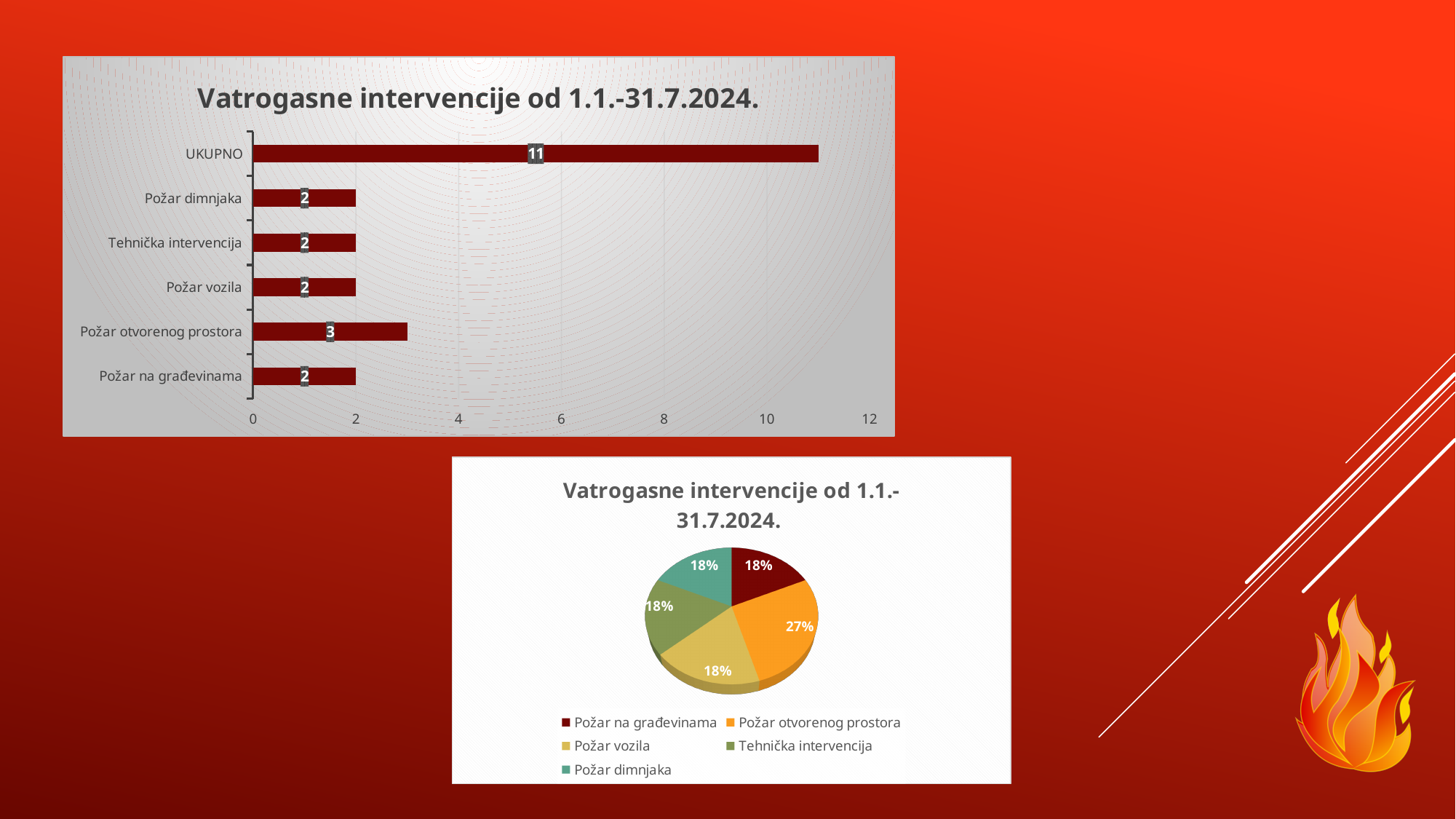
In the pie chart at the bottom of the slide, what share does Požar otvorenog prostora have? 27% In the bar chart at the top of the slide, what is the difference between UKUPNO and Požar otvorenog prostora? 8 In the bar chart at the top of the slide, what is the value for Požar dimnjaka? 2 In the bar chart at the top of the slide, what is the value for Požar otvorenog prostora? 3 How many categories are shown in the bar chart at the top of the slide? 6 What is the title of the bar chart at the top of the slide? Vatrogasne intervencije od 1.1.-31.7.2024. How many entries does the legend of the pie chart at the bottom of the slide list? 5 In the bar chart at the top of the slide, which category has the highest value? UKUPNO In the pie chart at the bottom of the slide, what share does Tehnička intervencija have? 18% What kind of chart is the chart at the top of the slide? bar chart In the bar chart at the top of the slide, what is the value for UKUPNO? 11 In the bar chart at the top of the slide, which is larger: Požar otvorenog prostora or Požar vozila? Požar otvorenog prostora